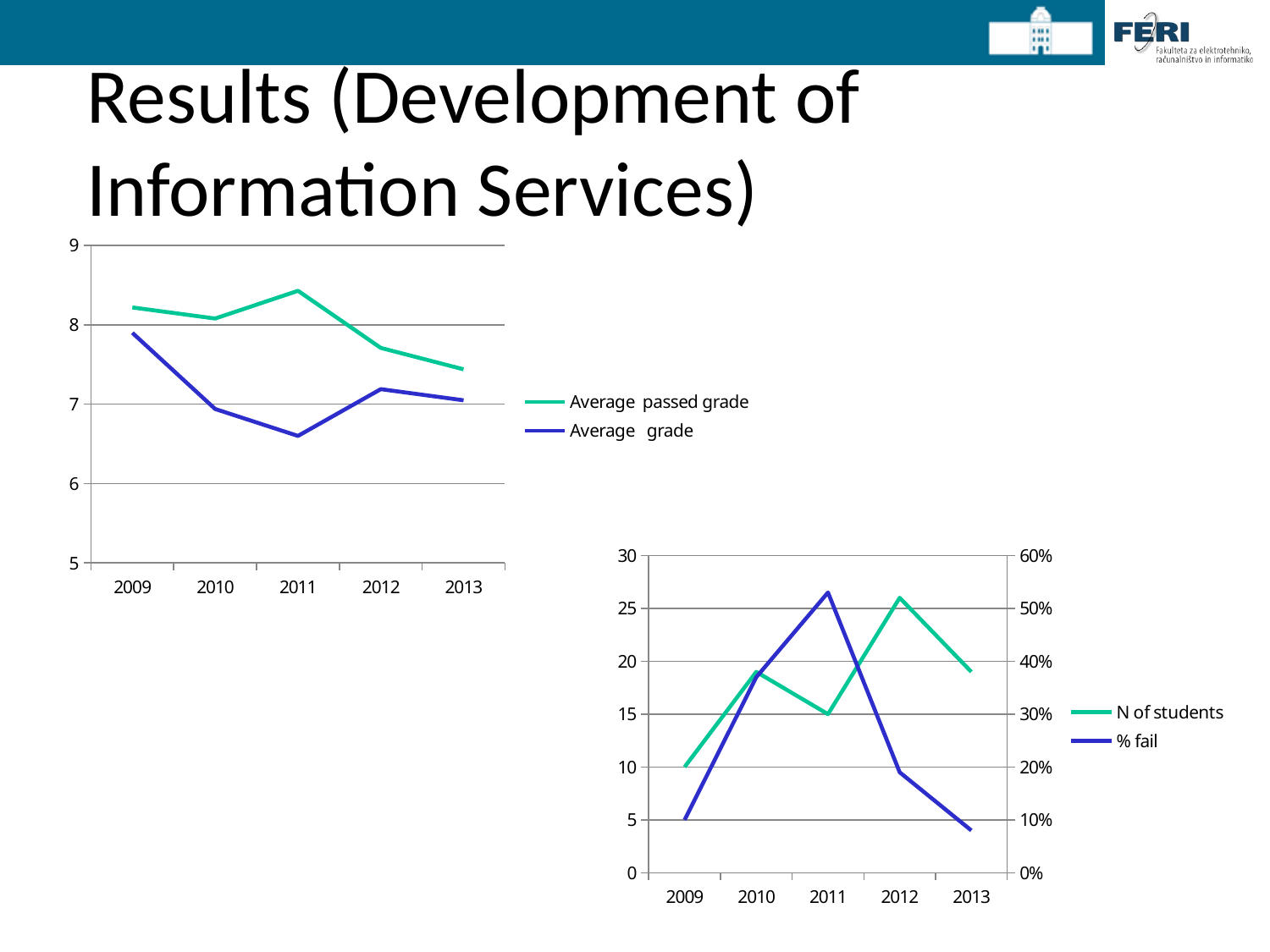
In the chart on the right of the slide, which year has the lowest % fail? 2013 In the chart on the left of the slide, is the Average passed grade for 2009 greater or less than 8? greater How many series does the legend of the chart on the right of the slide list? 2 In the chart on the left of the slide, does the Average grade rise or fall from 2009 to 2011? fall In the chart on the left of the slide, is the Average grade for 2011 greater or less than 7? less In the chart on the right of the slide, is the % fail for 2011 greater or less than 40%? greater In the chart on the right of the slide, is N of students larger in 2011 or in 2012? 2012 In the chart on the left of the slide, which year has the highest Average passed grade? 2011 What kind of chart is the chart on the left of the slide? line chart In the chart on the right of the slide, which year has the highest N of students? 2012 How many years are shown on the x axis of the chart on the left of the slide? 5 In the chart on the left of the slide, which year has the lowest Average grade? 2011